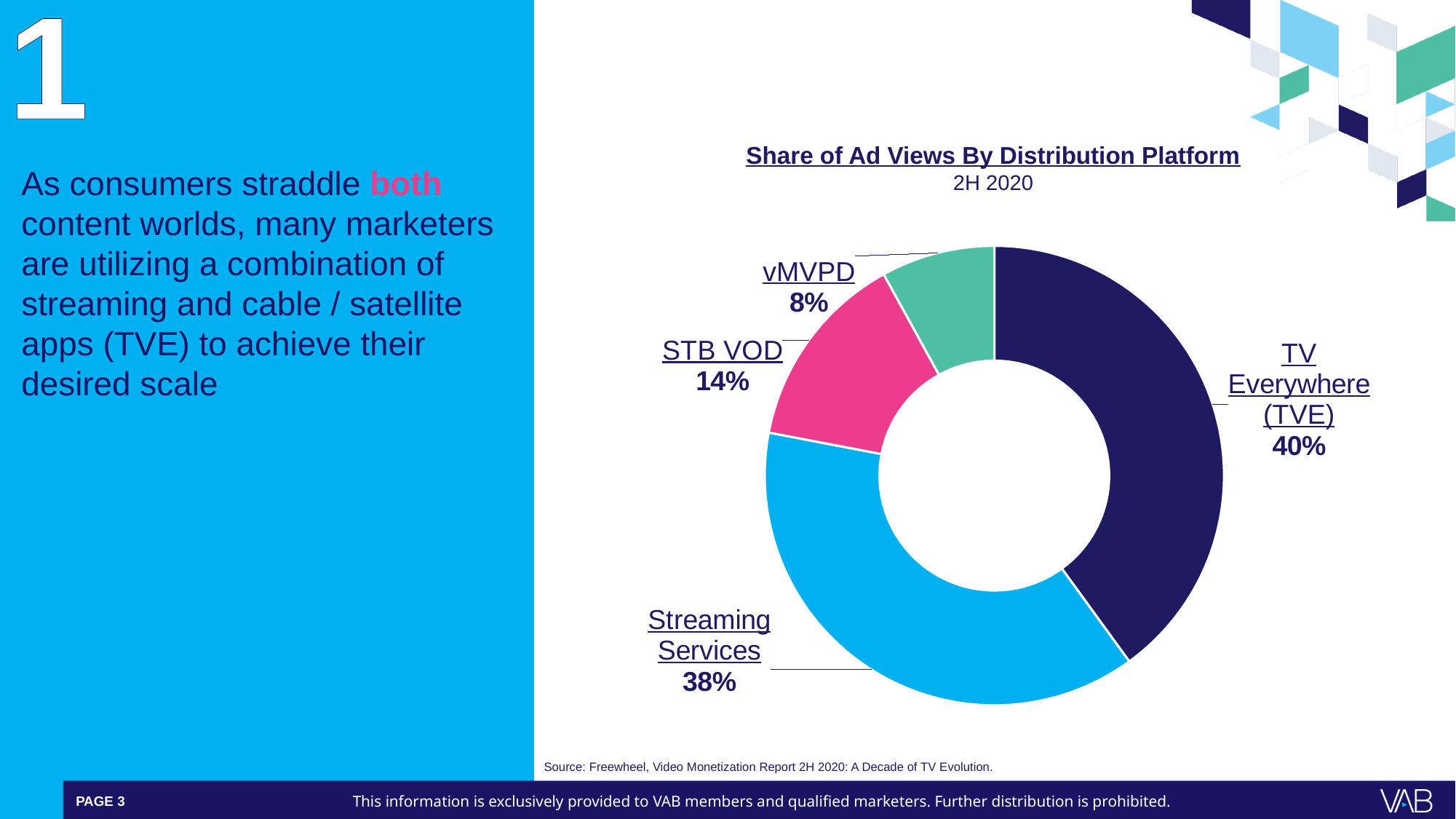
What share of ad views does vMVPD have? 8% Which has a larger share of ad views, Streaming Services or STB VOD? Streaming Services What share of ad views does TV Everywhere (TVE) have? 40% What is the difference in share between STB VOD and vMVPD? 6 percentage points How many distribution platforms are shown in the chart? 4 What share of ad views does STB VOD have? 14% Which distribution platform has the largest share of ad views? TV Everywhere (TVE) Which distribution platform has the smallest share of ad views? vMVPD What share of ad views do Streaming Services have? 38% What time period does the chart cover? 2H 2020 What type of chart is used to show the share of ad views? Doughnut (pie) chart What is the title of the chart? Share of Ad Views By Distribution Platform